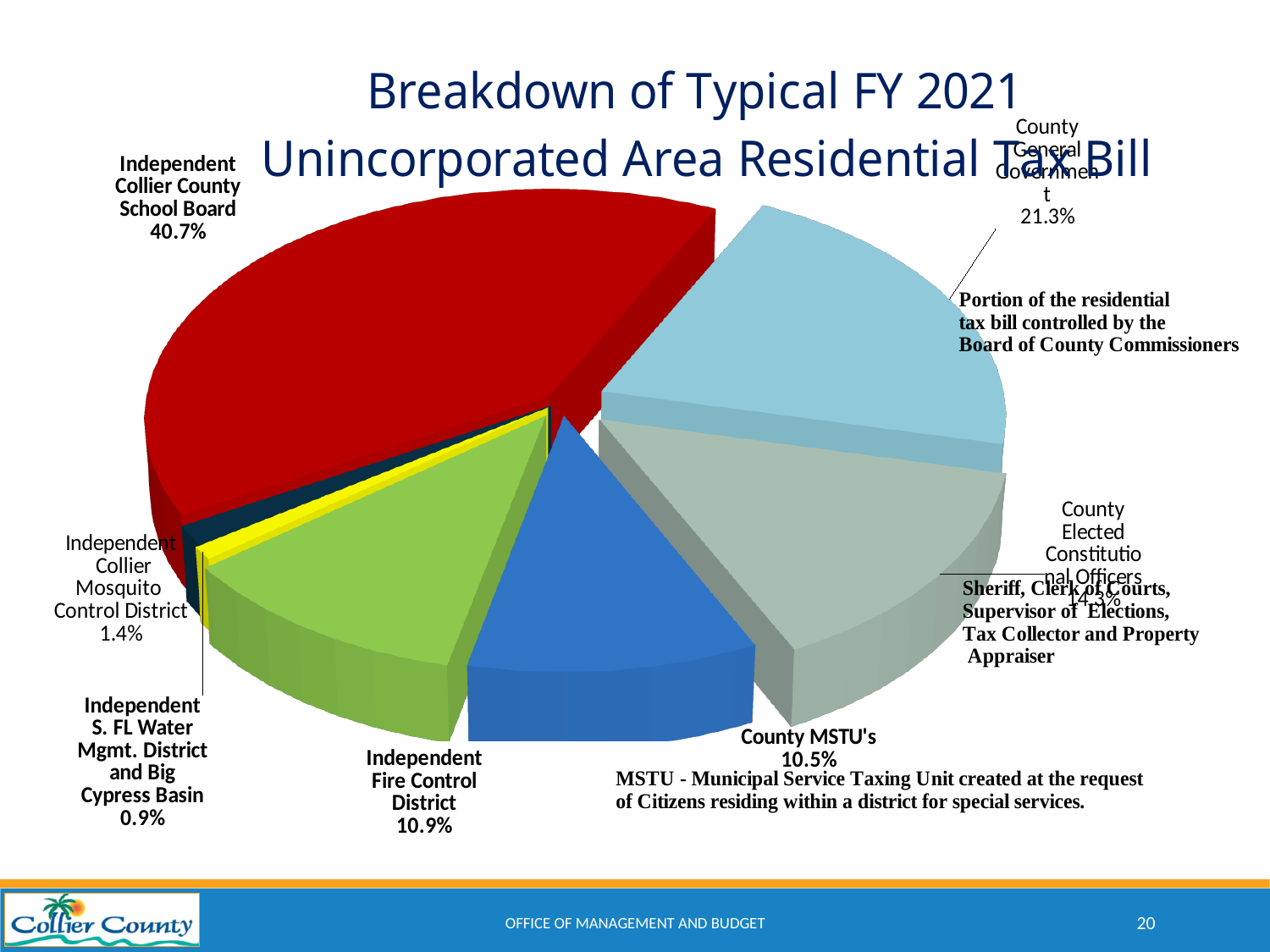
What percentage of the tax bill goes to the Independent Fire Control District? 10.9% What percentage of the tax bill goes to the Independent S. FL Water Mgmt. District and Big Cypress Basin? 0.9% What share of the typical FY 2021 residential tax bill goes to the Independent Collier County School Board? 40.7% Which slice of the pie chart is the smallest? Independent S. FL Water Mgmt. District and Big Cypress Basin Which has the larger share of the tax bill, the Independent Fire Control District or County MSTU's? Independent Fire Control District Which slice of the pie chart is the largest? Independent Collier County School Board What share of the tax bill goes to the Independent Collier Mosquito Control District? 1.4% What kind of chart is shown on the slide? Pie chart What percentage of the tax bill is attributed to County General Government? 21.3% What share of the tax bill goes to County MSTU's? 10.5% How many slices does the pie chart have? 7 How many percentage points larger is the Independent Collier County School Board share than the County General Government share? 19.4 percentage points